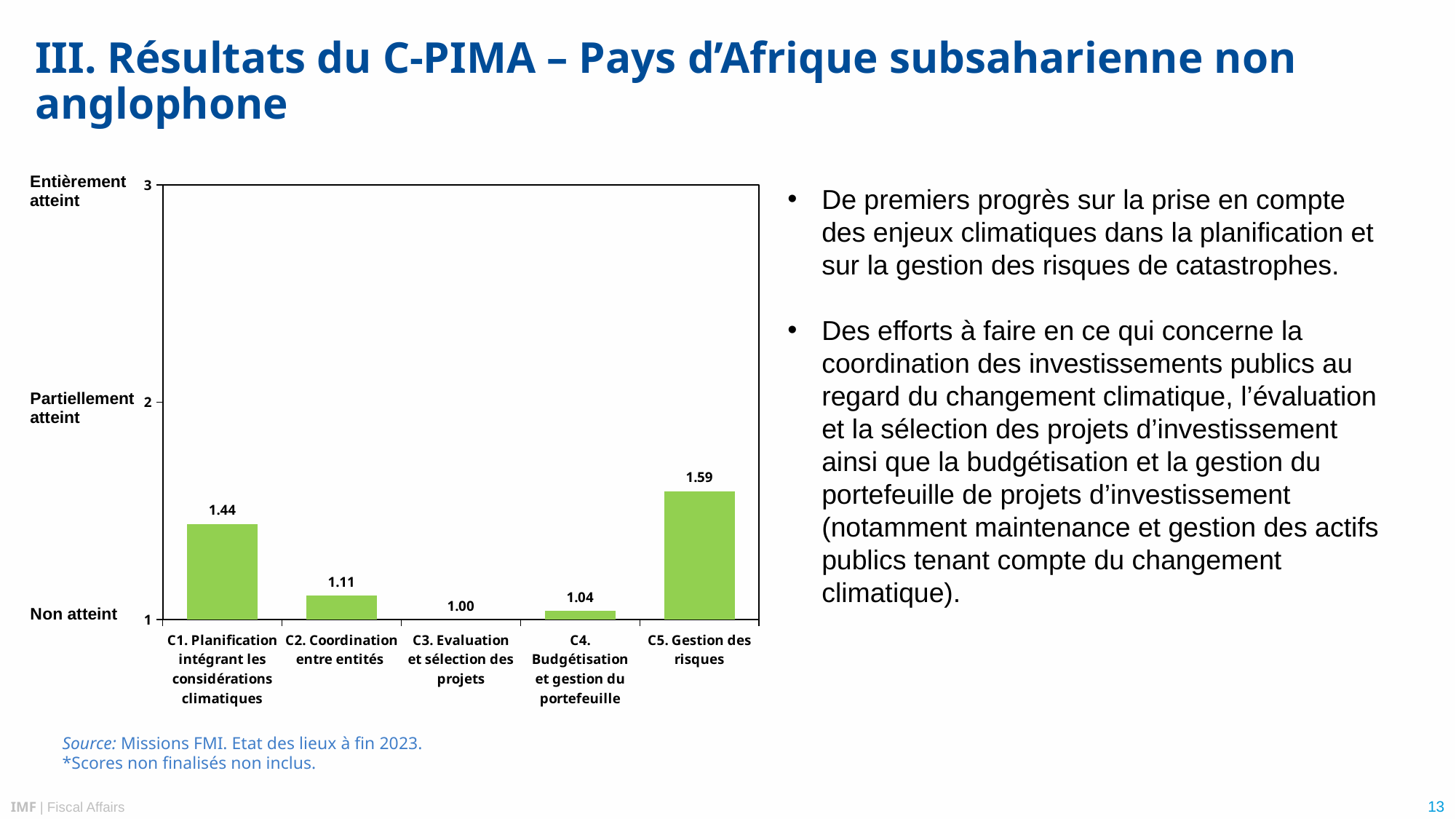
What label does the y axis show at the value 3? Entièrement atteint Which is larger, the value for C2. Coordination entre entités or the value for C4. Budgétisation et gestion du portefeuille? C2. Coordination entre entités Which category has the highest value? C5. Gestion des risques What is the value for C3. Evaluation et sélection des projets? 1.00 Which category has the lowest value? C3. Evaluation et sélection des projets What kind of chart is shown on the slide? bar chart What is the value for C4. Budgétisation et gestion du portefeuille? 1.04 What is the value for C1. Planification intégrant les considérations climatiques? 1.44 What is the value for C5. Gestion des risques? 1.59 How many categories are shown on the x axis? 5 Is the value for C5. Gestion des risques greater or less than 2? less What is the difference between the values for C5. Gestion des risques and C1. Planification intégrant les considérations climatiques? 0.15